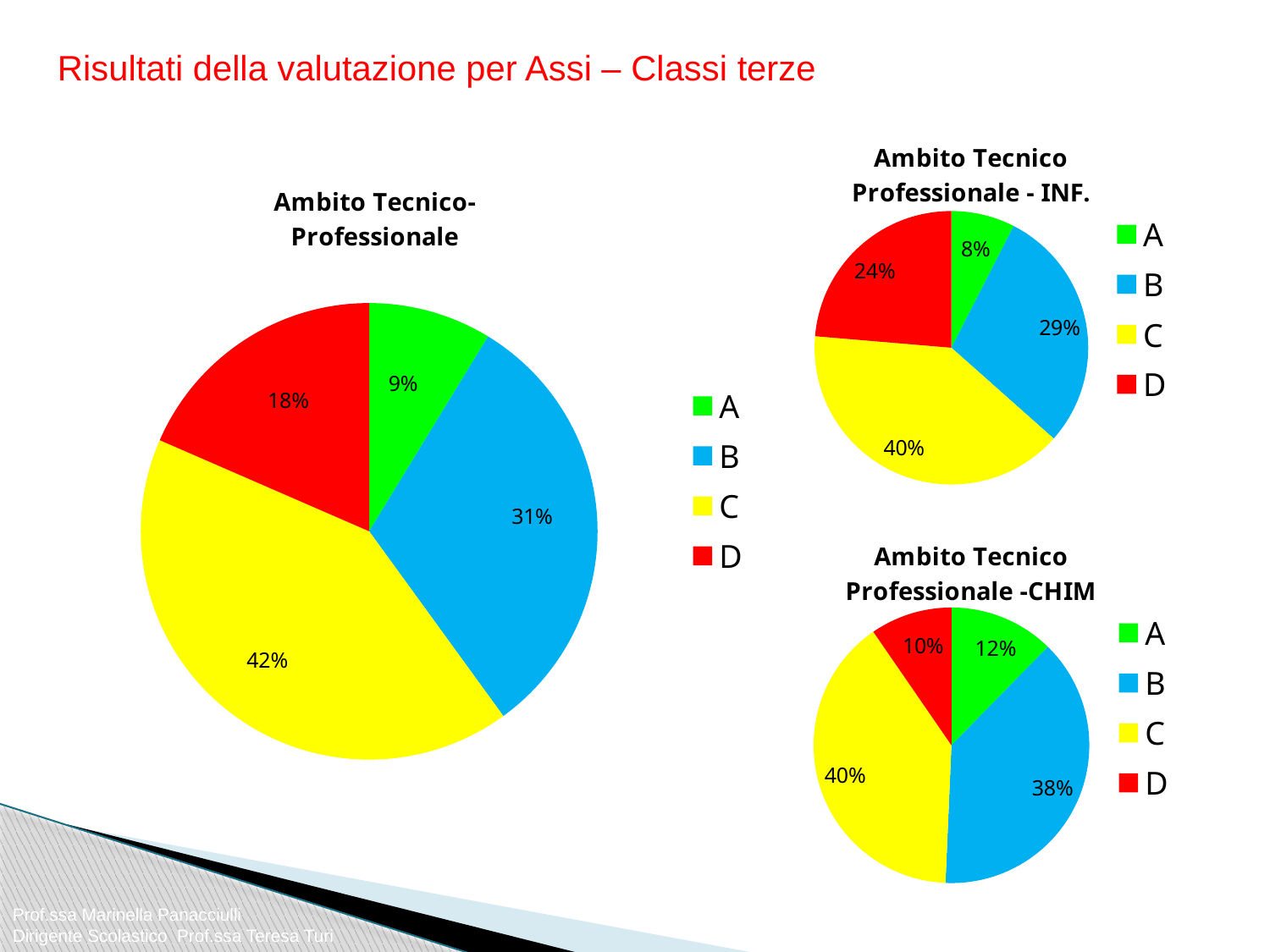
How many slices does the 'Ambito Tecnico Professionale -CHIM' pie chart have? 4 In the 'Ambito Tecnico Professionale - INF.' pie chart, what share does category B have? 29% In the 'Ambito Tecnico Professionale -CHIM' pie chart, which category has the smallest share? D In the 'Ambito Tecnico-Professionale' pie chart, what colour is the slice for category B? Blue In the 'Ambito Tecnico-Professionale' pie chart, which category has the largest share? C In the 'Ambito Tecnico Professionale - INF.' pie chart, which category has the smallest share? A In the 'Ambito Tecnico Professionale - INF.' pie chart, which is larger, the share of B or the share of D? B What type of chart is 'Ambito Tecnico Professionale - INF.'? Pie chart In the 'Ambito Tecnico Professionale -CHIM' pie chart, what share does category A have? 12% In the 'Ambito Tecnico-Professionale' pie chart, what share does category C have? 42% In the 'Ambito Tecnico-Professionale' pie chart, what share does category D have? 18% In the 'Ambito Tecnico-Professionale' pie chart, what is the difference between the shares of C and B? 11%